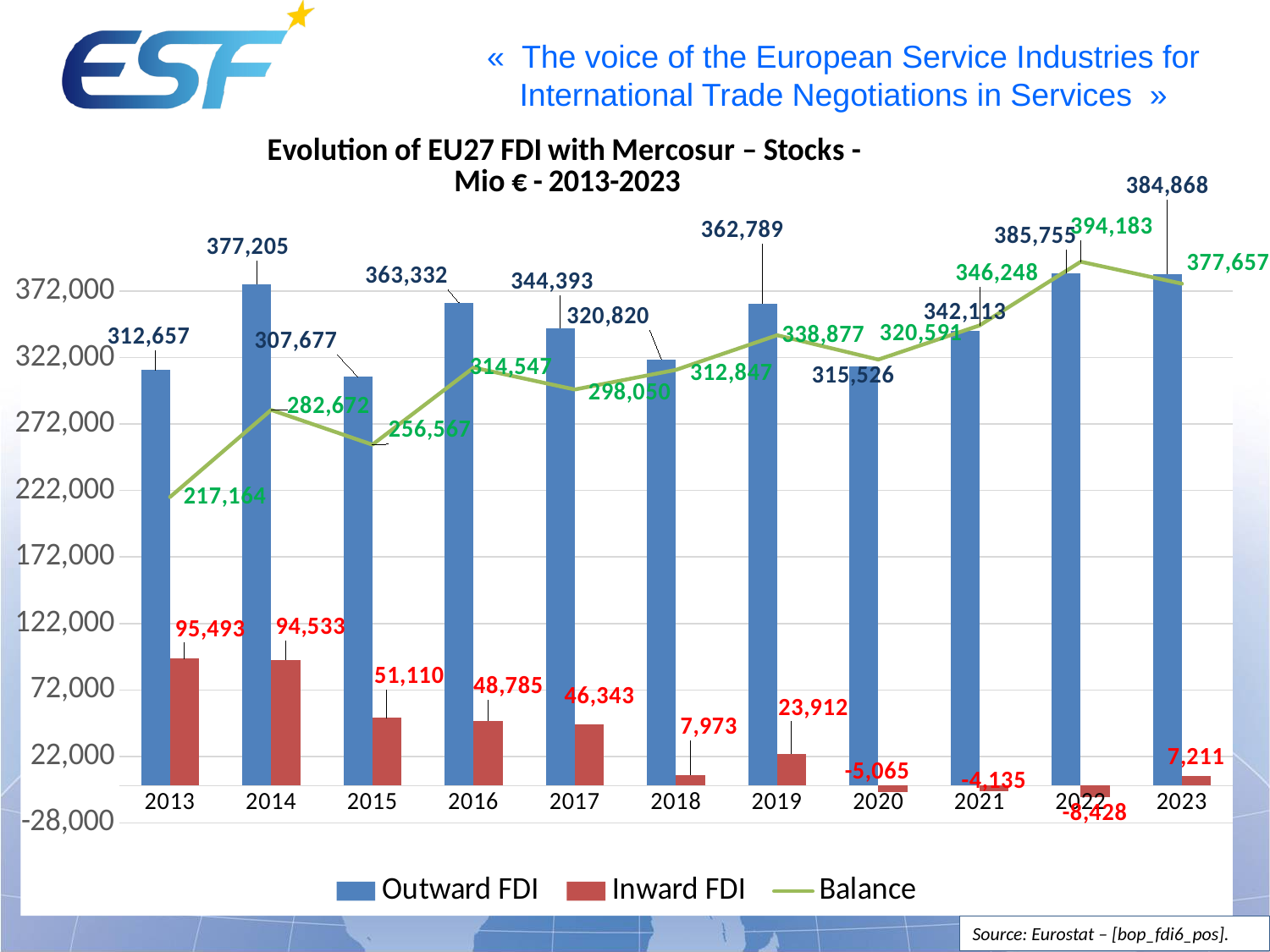
Does the Balance line overall rise or fall from 2013 to 2023? rise What is the difference between the Outward FDI values for 2014 and 2013? 64,548 What is the Inward FDI value for 2022? -8,428 Is the Inward FDI value for 2013 greater or less than 72,000? greater What is the Outward FDI value for 2019? 362,789 What is the Inward FDI value for 2015? 51,110 Which year has the larger Inward FDI value, 2017 or 2019? 2017 What is the Balance value for 2022? 394,183 How many years are shown on the x axis? 11 How many series does the legend list? 3 In which year is the Balance lowest? 2013 In which year is the Balance highest? 2022